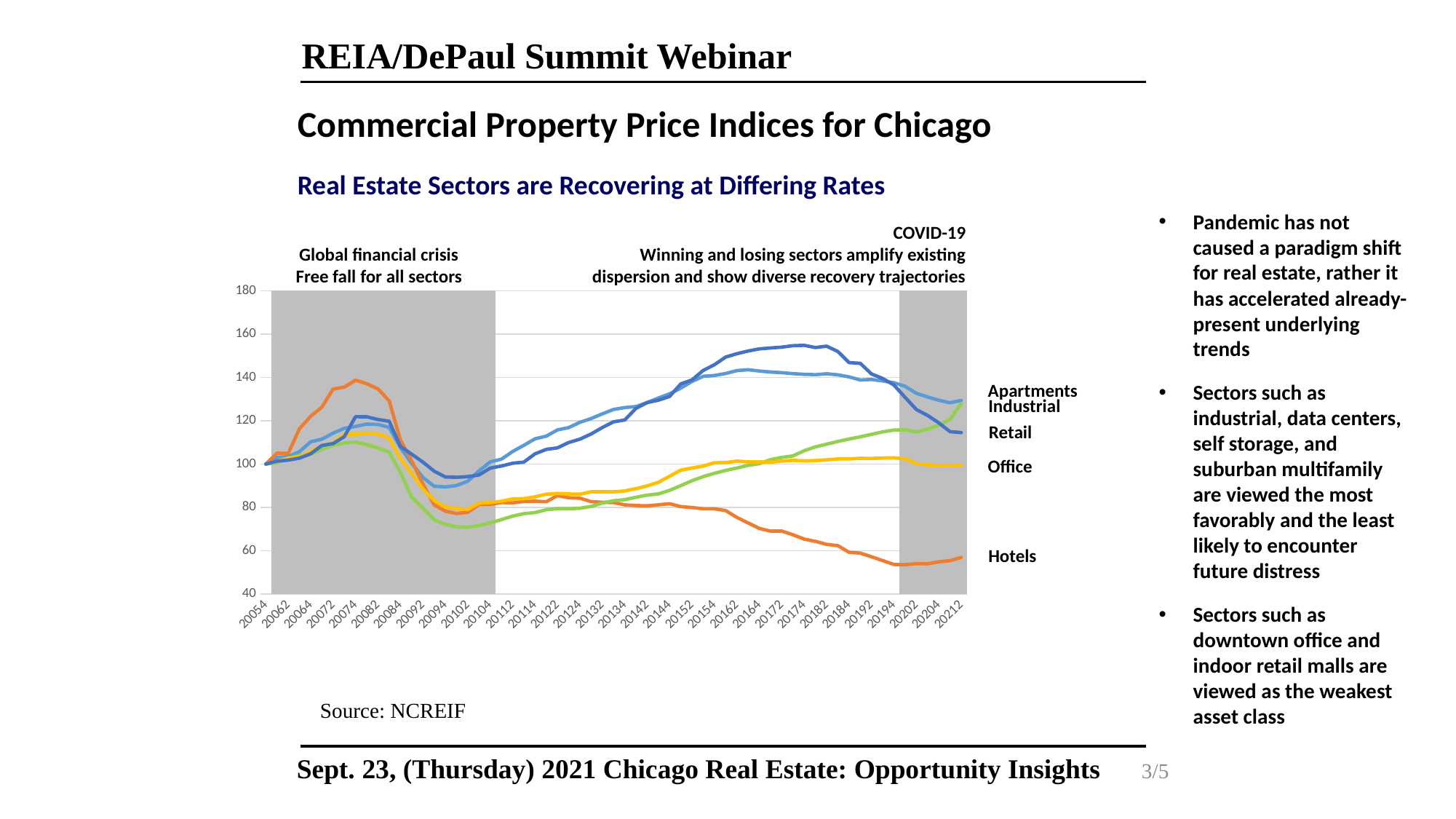
What are the two shaded periods on the chart labelled? Global financial crisis and COVID-19 Is the Industrial index value at 20212 greater or less than 120? greater How many sector series are labelled on the chart? 5 Is the Hotels index value at 20212 greater or less than 80? less Does the Hotels index rise or fall between 20162 and 20212? fall Does the Industrial index rise or fall between 20104 and 20212? rise What index value do all sectors start at in 20054? 100 Is the Office index value at 20212 greater or less than 120? less What kind of chart is shown on the slide? line chart At 20212, which is larger, the Office index or the Hotels index? Office Which sector has the lowest index value at the end of the chart (20212)? Hotels